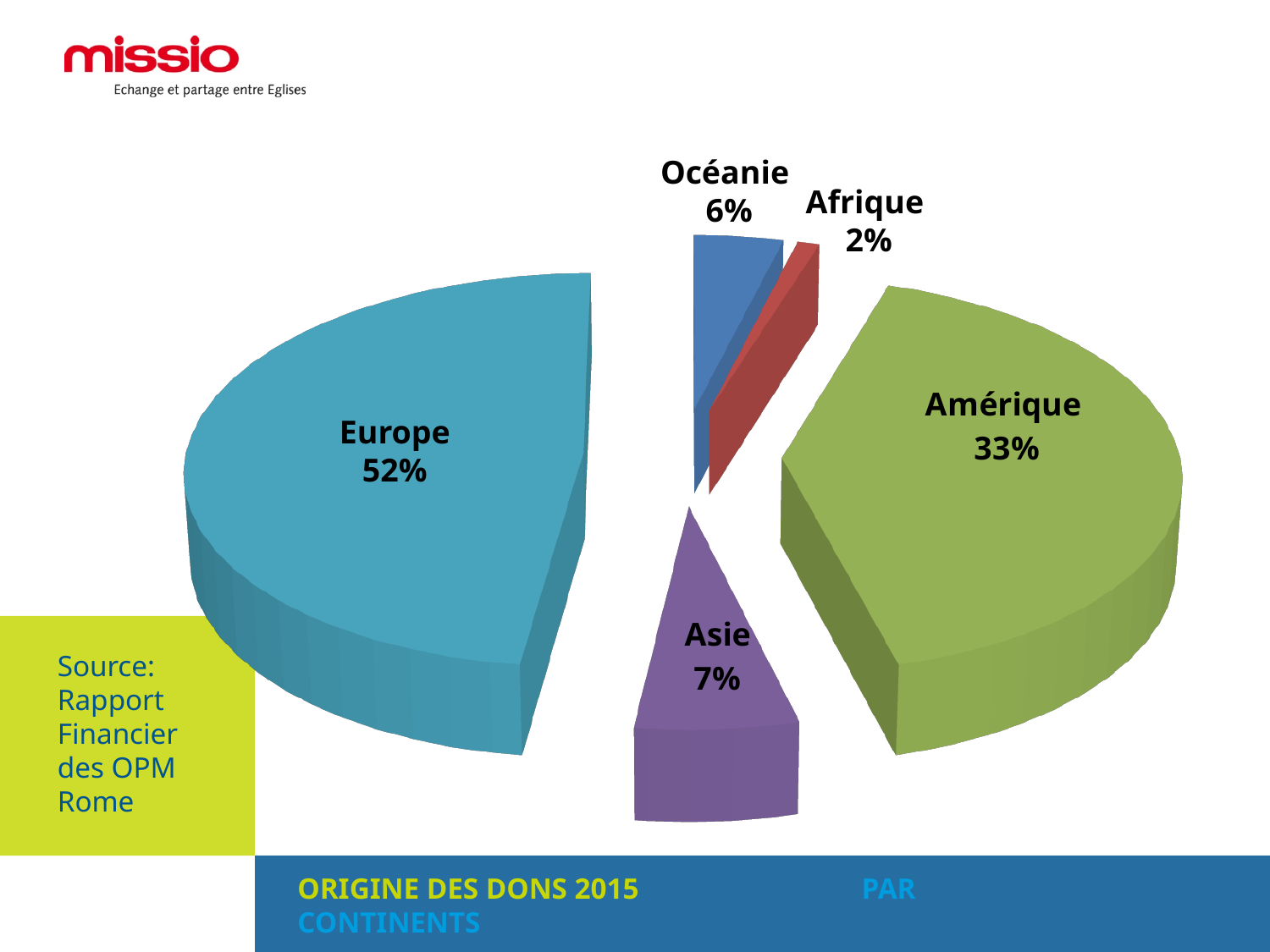
What share of the pie does Europe represent? 52% What percentage is shown for Asie? 7% What is the difference in percentage points between Europe and Amérique? 19 Which continent has the smallest share of donations? Afrique What is the value shown for Amérique? 33% Which is larger, the share for Asie or the share for Océanie? Asie What colour is the slice for Amérique? Green What percentage is shown for Océanie? 6% What type of chart is shown on the slide? Pie chart Which continent has the largest share of donations? Europe What percentage is shown for Afrique? 2% How many continents are shown in the pie chart? 5